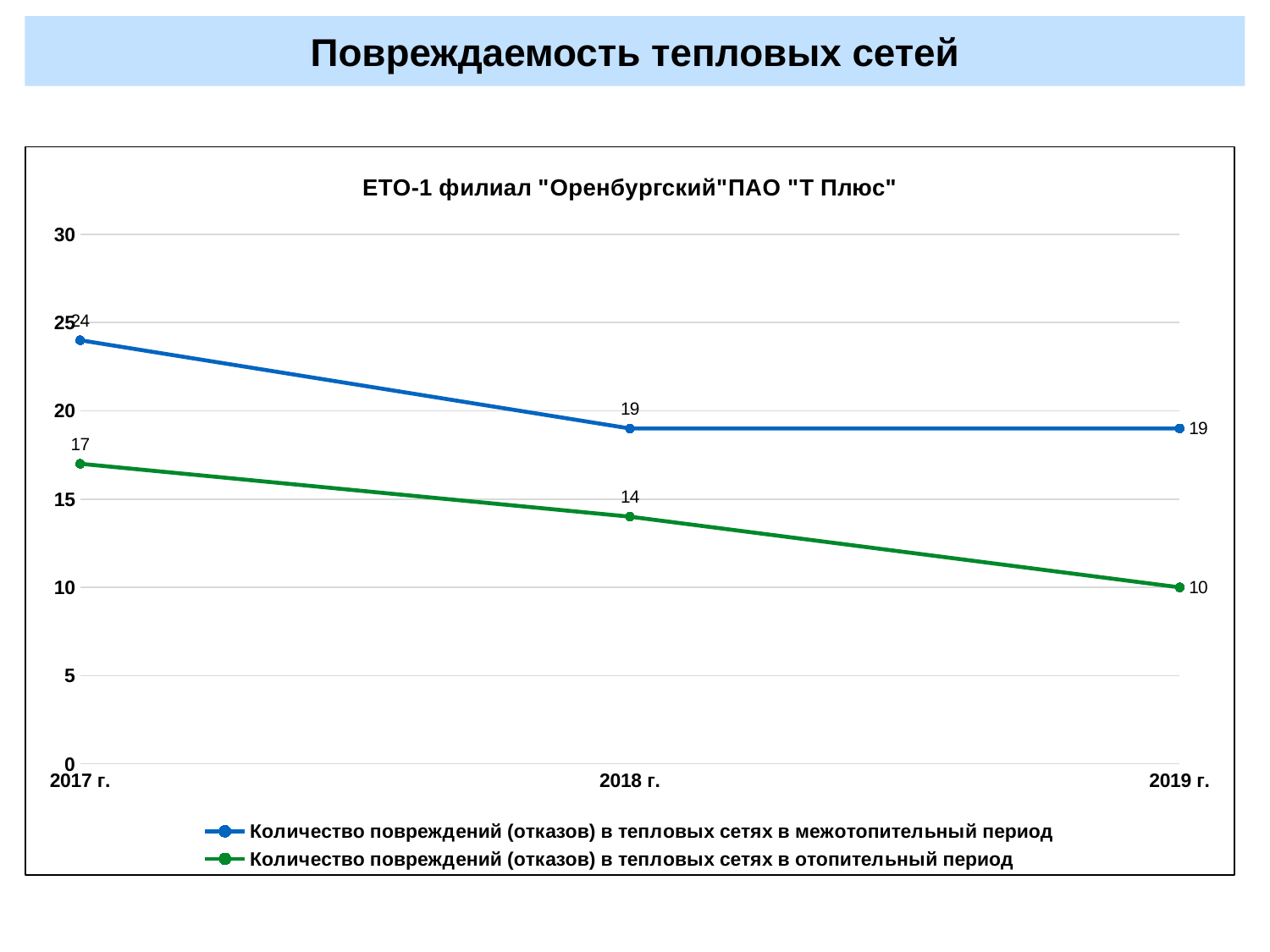
What type of chart is shown on the slide? line chart What is the difference between the 2017 г. and 2019 г. values for the series 'Количество повреждений (отказов) в тепловых сетях в отопительный период'? 7 Which series has the larger value in 2018 г.: 'межотопительный период' or 'отопительный период'? Количество повреждений (отказов) в тепловых сетях в межотопительный период Does the series 'Количество повреждений (отказов) в тепловых сетях в отопительный период' rise or fall from 2017 г. to 2019 г.? fall In which year is the value for the series 'Количество повреждений (отказов) в тепловых сетях в отопительный период' lowest? 2019 г. What is the value for 2017 г. for the series 'Количество повреждений (отказов) в тепловых сетях в межотопительный период'? 24 How many series does the legend list? 2 What is the title of the chart? ЕТО-1 филиал "Оренбургский"ПАО "Т Плюс" What is the value for 2018 г. for the series 'Количество повреждений (отказов) в тепловых сетях в отопительный период'? 14 In which year is the value for the series 'Количество повреждений (отказов) в тепловых сетях в межотопительный период' highest? 2017 г. How many years are shown on the x axis? 3 What is the value for 2019 г. for the series 'Количество повреждений (отказов) в тепловых сетях в отопительный период'? 10